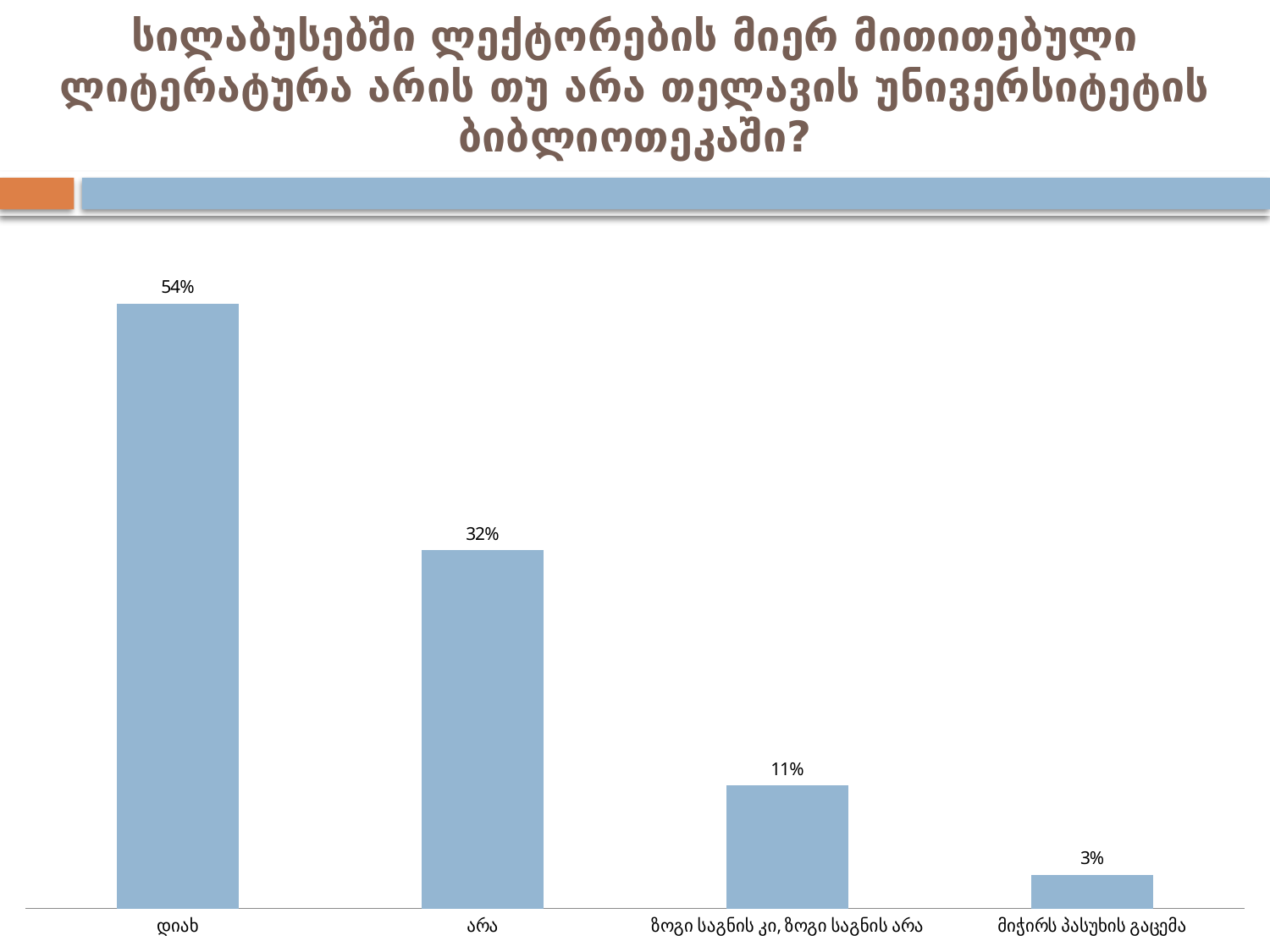
What is the value for ზოგი საგნის კი, ზოგი საგნის არა? 11% Which is larger, the value for არა or the value for ზოგი საგნის კი, ზოგი საგნის არა? არა How many categories are shown in the chart? 4 What is the difference between the values for დიახ and არა? 22% What kind of chart is shown on the slide? bar chart Which category has the highest value? დიახ What is the value for მიჭირს პასუხის გაცემა? 3% What is the difference between the values for ზოგი საგნის კი, ზოგი საგნის არა and მიჭირს პასუხის გაცემა? 8% Which category has the lowest value? მიჭირს პასუხის გაცემა Do the values rise or fall from left to right across the categories? fall What is the value for დიახ? 54% What is the value for არა? 32%